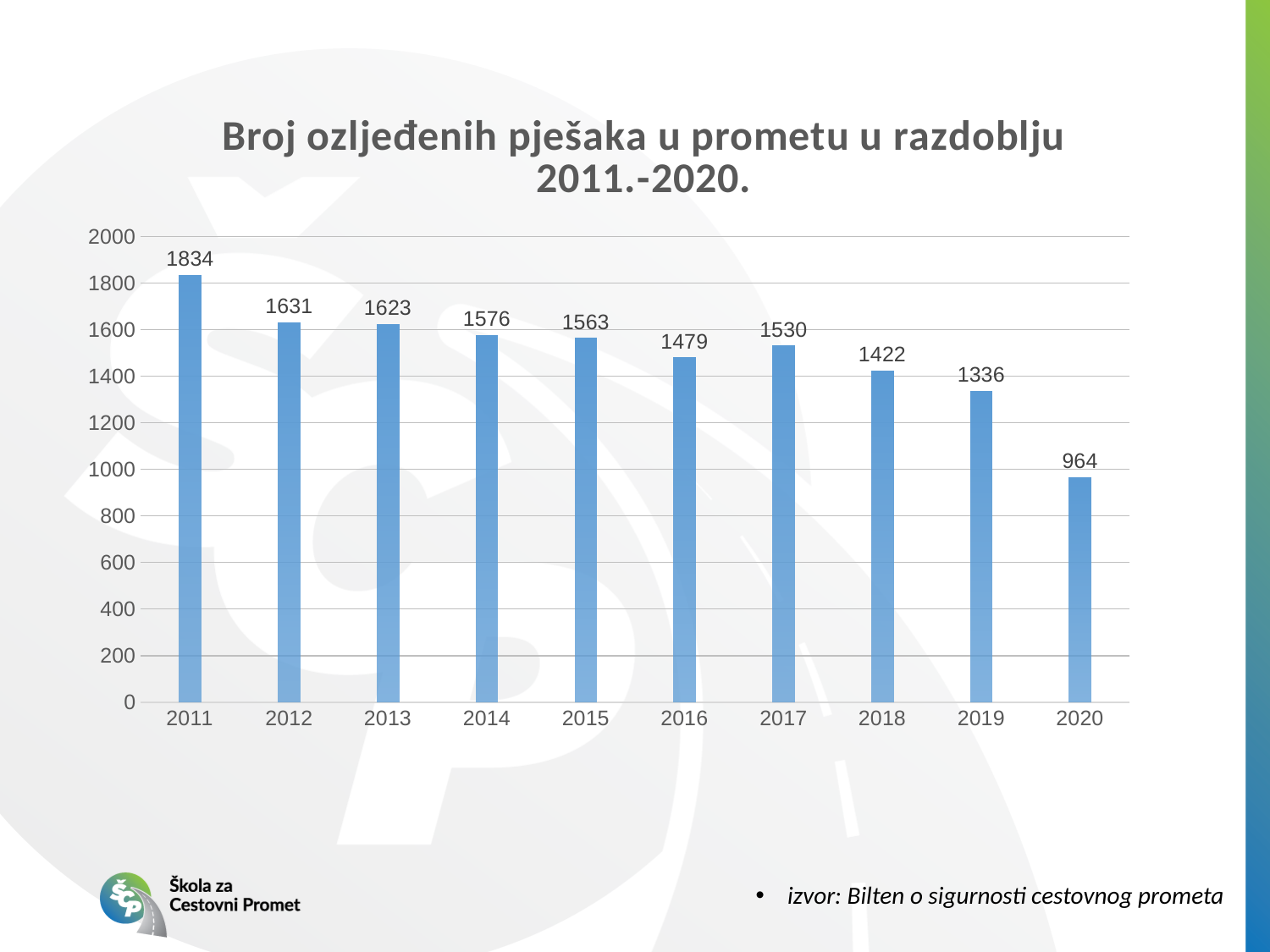
What is the difference between the values for 2016 and 2017? 51 Which year has the highest value? 2011 What is the value for 2020? 964 How many years are shown on the x axis? 10 Which is larger, the value for 2014 or the value for 2018? 2014 Is the value for 2019 greater or less than 1400? less Which year has the lowest value? 2020 What is the difference between the values for 2011 and 2020? 870 What is the value for 2011? 1834 What is the value for 2017? 1530 What kind of chart is shown on the slide? bar chart What is the title of the chart? Broj ozljeđenih pješaka u prometu u razdoblju 2011.-2020.